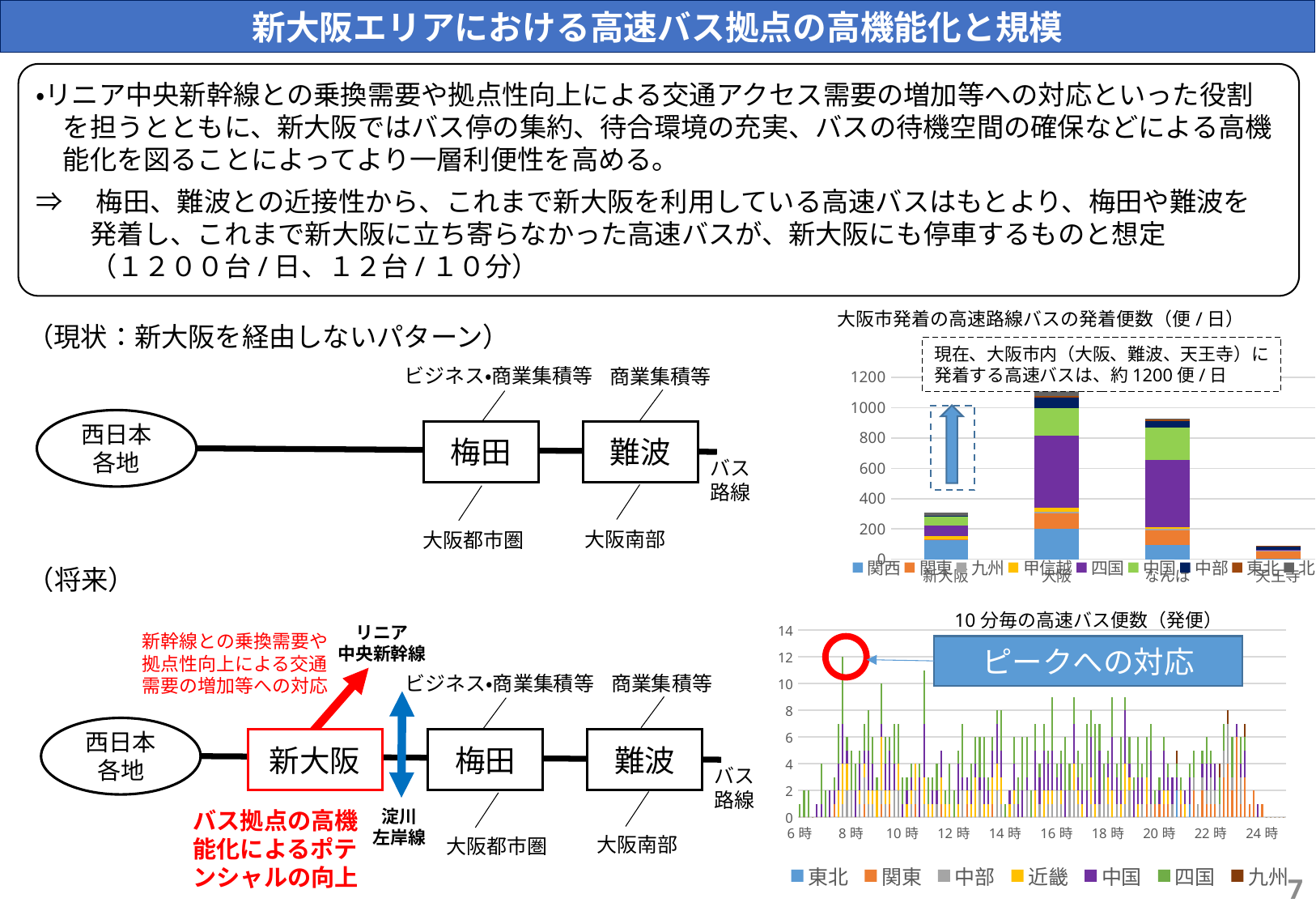
What kind of chart is the one titled 10分毎の高速バス便数（発便）? bar chart In the chart titled 大阪市発着の高速路線バスの発着便数（便/日）, which category has the shortest stacked bar? 天王寺 In the chart titled 大阪市発着の高速路線バスの発着便数（便/日）, is the total for 新大阪 greater or less than 400? less In the chart titled 大阪市発着の高速路線バスの発着便数（便/日）, is the total for 大阪 greater or less than 1000? greater In the chart titled 大阪市発着の高速路線バスの発着便数（便/日）, is the total for 天王寺 greater or less than 200? less What kind of chart is the one titled 大阪市発着の高速路線バスの発着便数（便/日）? stacked bar chart In the chart titled 大阪市発着の高速路線バスの発着便数（便/日）, which category has the tallest stacked bar? 大阪 In the chart titled 大阪市発着の高速路線バスの発着便数（便/日）, which has the larger total, 新大阪 or なんば? なんば How many categories are shown on the x axis of the chart titled 大阪市発着の高速路線バスの発着便数（便/日）? 4 How many series does the legend of the chart titled 10分毎の高速バス便数（発便） list? 7 What is the highest value shown on the y axis of the chart titled 10分毎の高速バス便数（発便）? 14